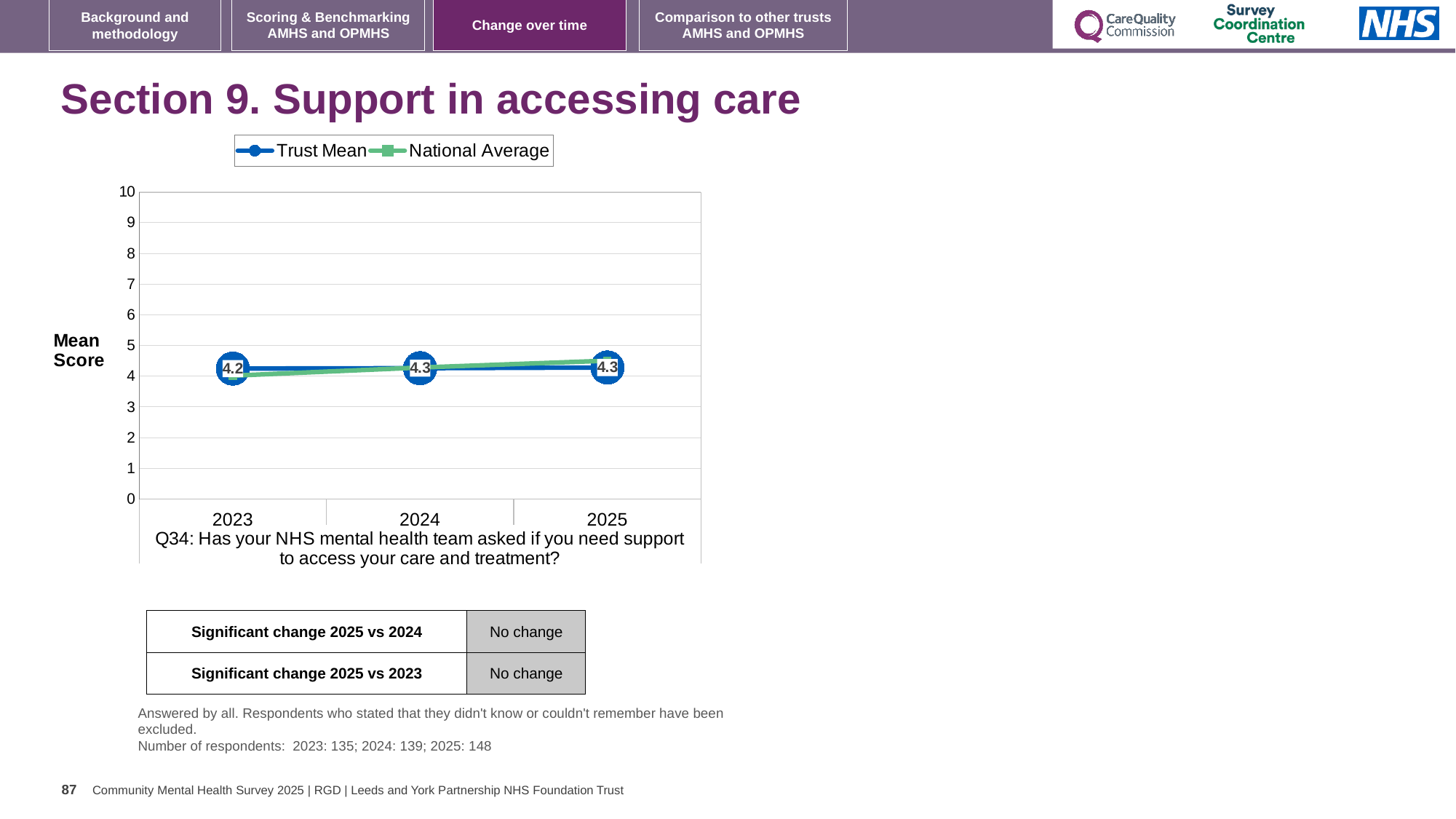
In which year is the Trust Mean score lowest? 2023 How many series does the legend list? 2 Is the Trust Mean score for 2024 larger or smaller than for 2023? Larger Is the National Average value for 2025 greater or less than 4? greater What label is shown on the y axis of the chart? Mean Score Does the Trust Mean score rise or fall from 2023 to 2025? Rises What kind of chart is shown on the slide? Line chart What is the difference between the Trust Mean score in 2025 and in 2023? 0.1 What is the Trust Mean score for 2025? 4.3 What is the Trust Mean score for 2024? 4.3 What is the Trust Mean score for 2023? 4.2 How many years are plotted on the x axis? 3